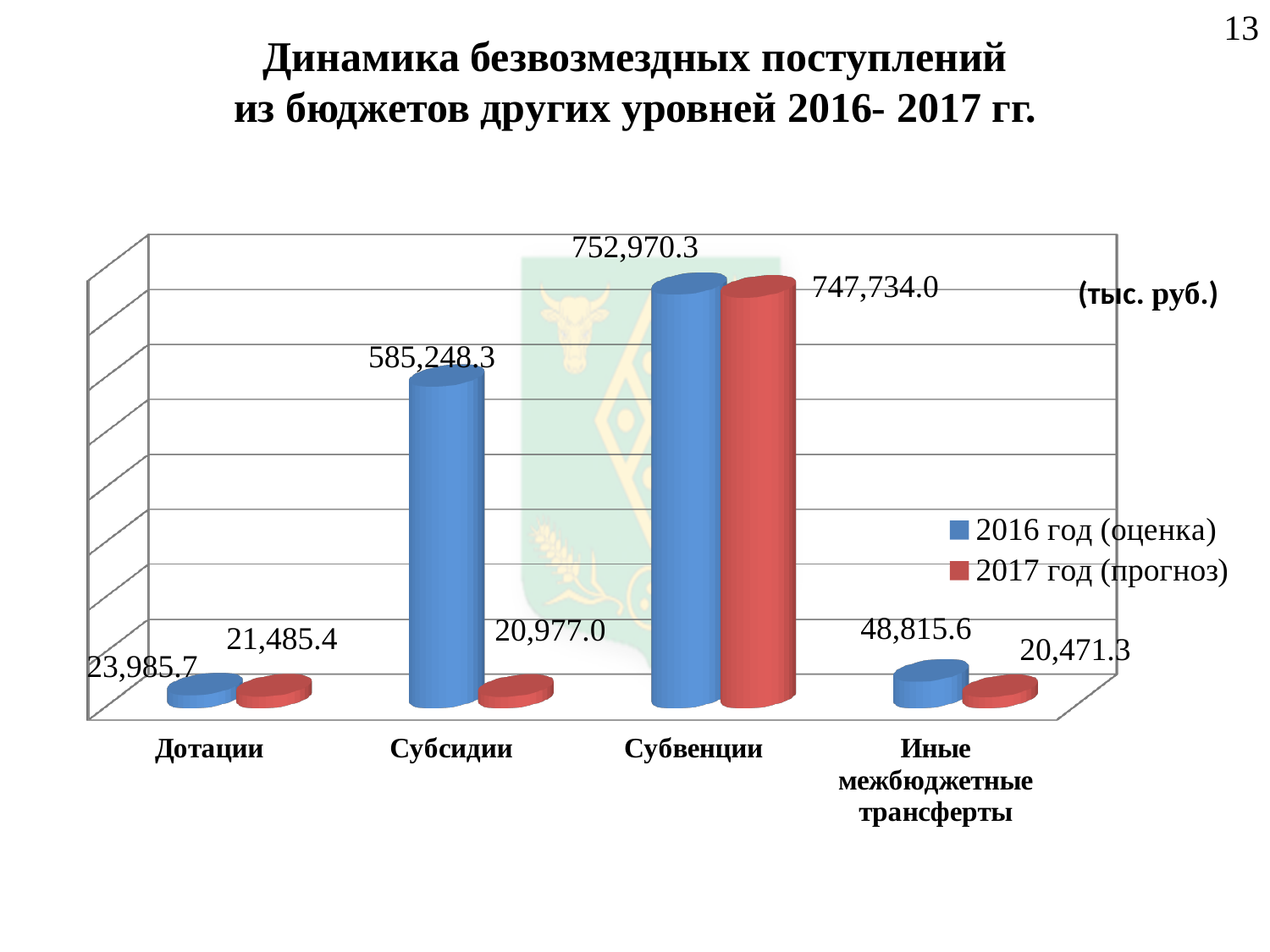
What type of chart is shown on the slide? Bar chart What is the value for Дотации in the 2017 год (прогноз) series? 21,485.4 How many categories are shown on the x axis? 4 Which is larger for Субсидии: the 2016 год (оценка) value or the 2017 год (прогноз) value? 2016 год (оценка) Which category has the highest value in the 2016 год (оценка) series? Субвенции What is the difference between the 2016 год (оценка) and 2017 год (прогноз) values for Субвенции? 5,236.3 What is the value for Иные межбюджетные трансферты in the 2016 год (оценка) series? 48,815.6 What is the value for Субвенции in the 2016 год (оценка) series? 752,970.3 How many series does the legend list? 2 Which category has the lowest value in the 2016 год (оценка) series? Дотации What is the value for Субсидии in the 2017 год (прогноз) series? 20,977.0 What unit is indicated on the chart? тыс. руб.